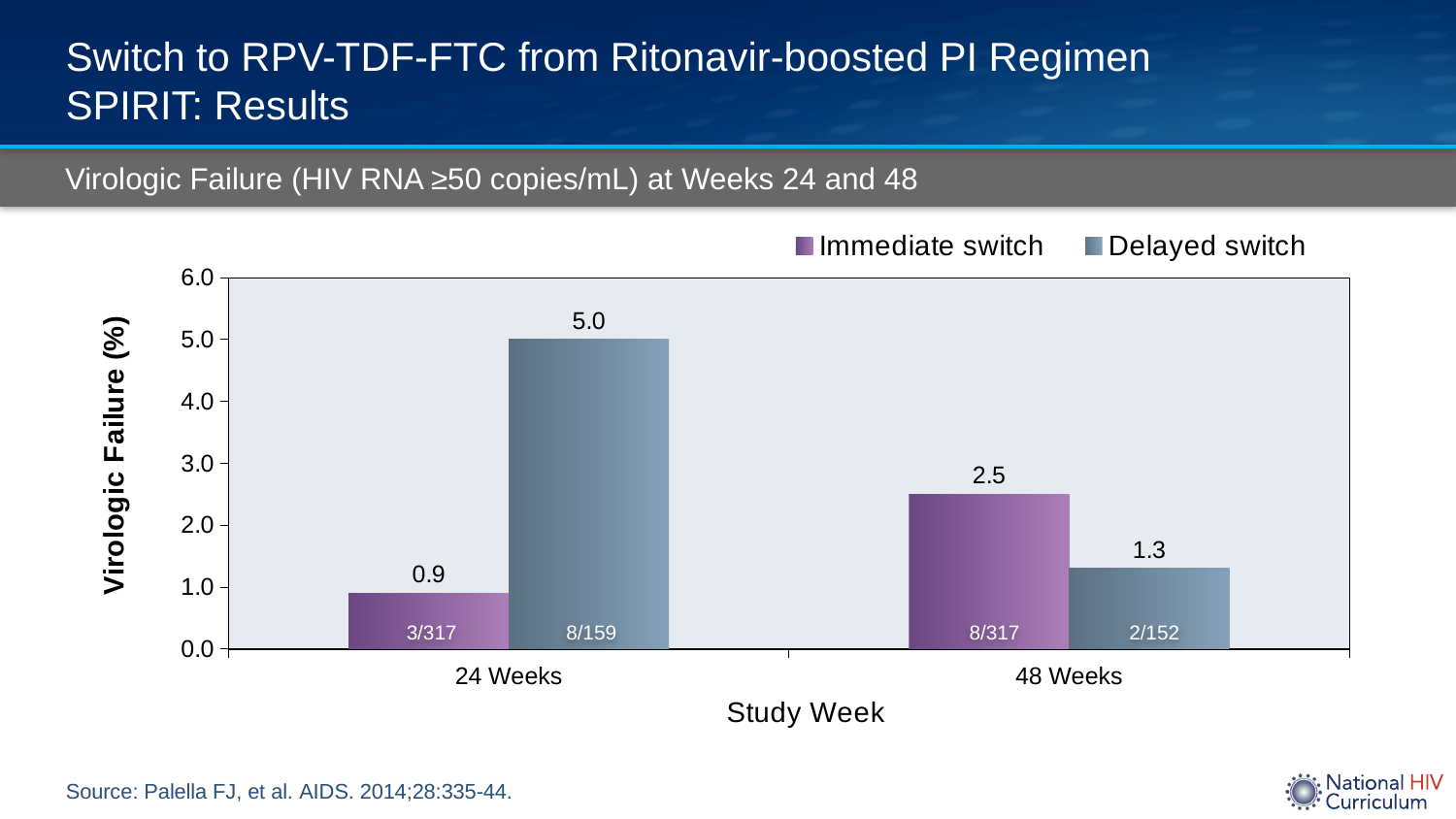
What is the difference between the Delayed switch and Immediate switch virologic failure rates at 24 Weeks? 4.1 What kind of chart is shown on the slide? Bar chart What is the virologic failure rate for Delayed switch at 24 Weeks? 5.0 Which series has the lowest virologic failure rate at 48 Weeks? Delayed switch What is the virologic failure rate for Immediate switch at 48 Weeks? 2.5 What is the virologic failure rate for Delayed switch at 48 Weeks? 1.3 How many series does the legend list? 2 What is the difference between the Immediate switch and Delayed switch virologic failure rates at 48 Weeks? 1.2 What is the label of the y axis? Virologic Failure (%) What is the virologic failure rate for Immediate switch at 24 Weeks? 0.9 Which series has the highest virologic failure rate at 24 Weeks? Delayed switch Is the Immediate switch virologic failure rate higher at 24 Weeks or at 48 Weeks? 48 Weeks